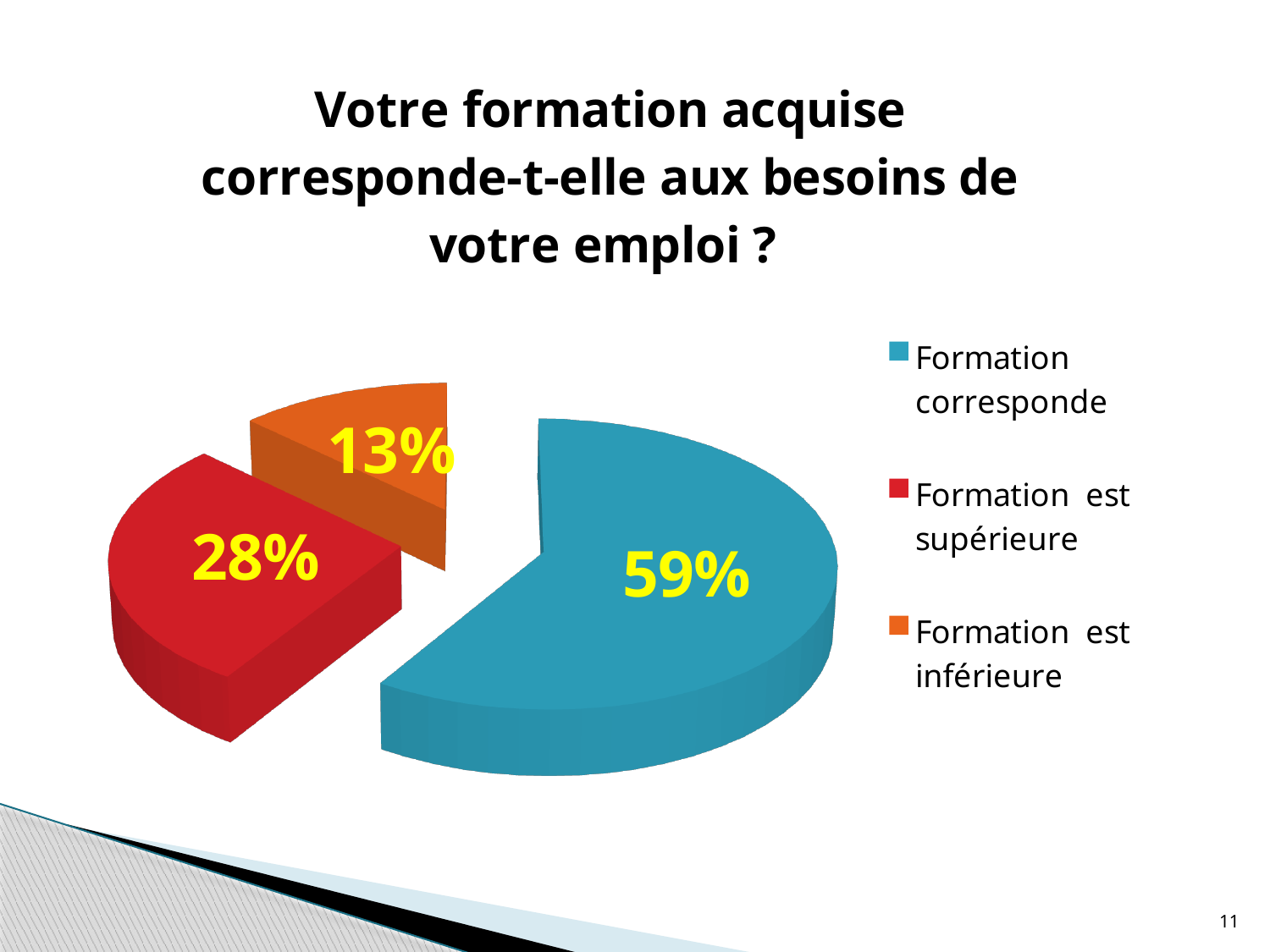
Which is larger: the slice for "Formation est supérieure" or the slice for "Formation est inférieure"? Formation est supérieure What share of the pie does "Formation corresponde" represent? 59% Which category has the smallest slice of the pie? Formation est inférieure How many categories are shown in the pie chart? 3 What colour is the slice for "Formation est supérieure"? Red What share of the pie does "Formation est supérieure" represent? 28% What share of the pie does "Formation est inférieure" represent? 13% What is the difference in percentage points between "Formation est supérieure" and "Formation est inférieure"? 15 Which category has the largest slice of the pie? Formation corresponde What is the title of the chart on the slide? Votre formation acquise corresponde-t-elle aux besoins de votre emploi ? What is the difference in percentage points between "Formation corresponde" and "Formation est supérieure"? 31 What kind of chart is shown on the slide? Pie chart